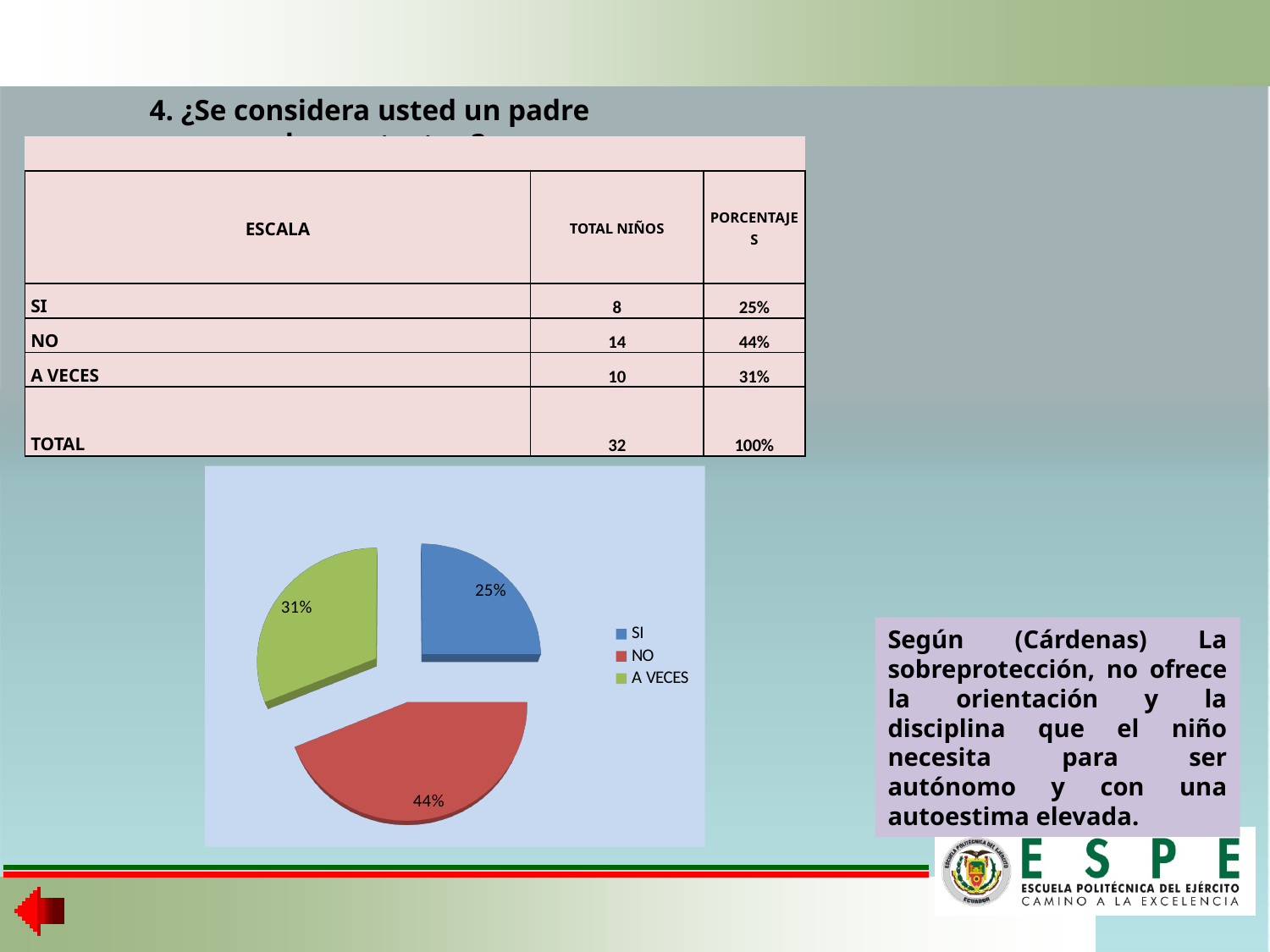
What colour is the NO slice in the pie chart? red Which slice is larger in the pie chart, A VECES or SI? A VECES What percentage does the SI slice of the pie chart show? 25% Which category has the largest slice in the pie chart? NO What percentage does the A VECES slice of the pie chart show? 31% What colour is the A VECES slice in the pie chart? green Which category has the smallest slice in the pie chart? SI What percentage does the NO slice of the pie chart show? 44% What kind of chart is shown on the slide? pie chart What is the difference in percentage points between the NO slice and the SI slice? 19 How many slices does the pie chart have? 3 How many entries does the legend of the pie chart list? 3